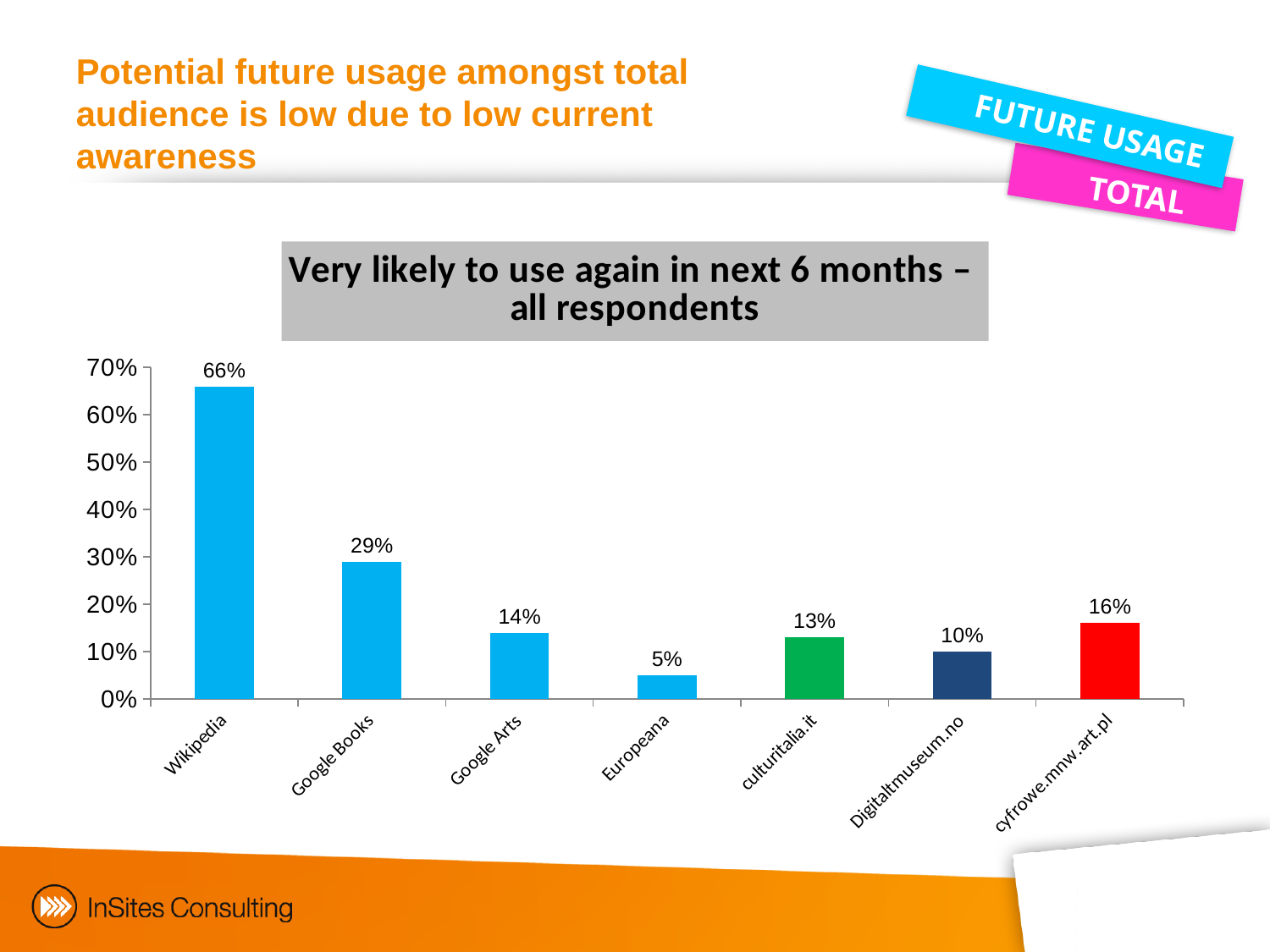
What is the title of the chart? Very likely to use again in next 6 months – all respondents How many categories are shown on the x axis? 7 Which category has the lowest value? Europeana What is the value for Google Books? 29% Which is larger, the value for culturitalia.it or the value for cyfrowe.mnw.art.pl? cyfrowe.mnw.art.pl What is the difference between the values for Google Arts and Digitaltmuseum.no? 4% What is the difference between the values for Wikipedia and Google Books? 37% What is the value for Europeana? 5% Which category has the highest value? Wikipedia What kind of chart is shown on the slide? Bar chart What is the value for cyfrowe.mnw.art.pl? 16% What is the value for Wikipedia? 66%